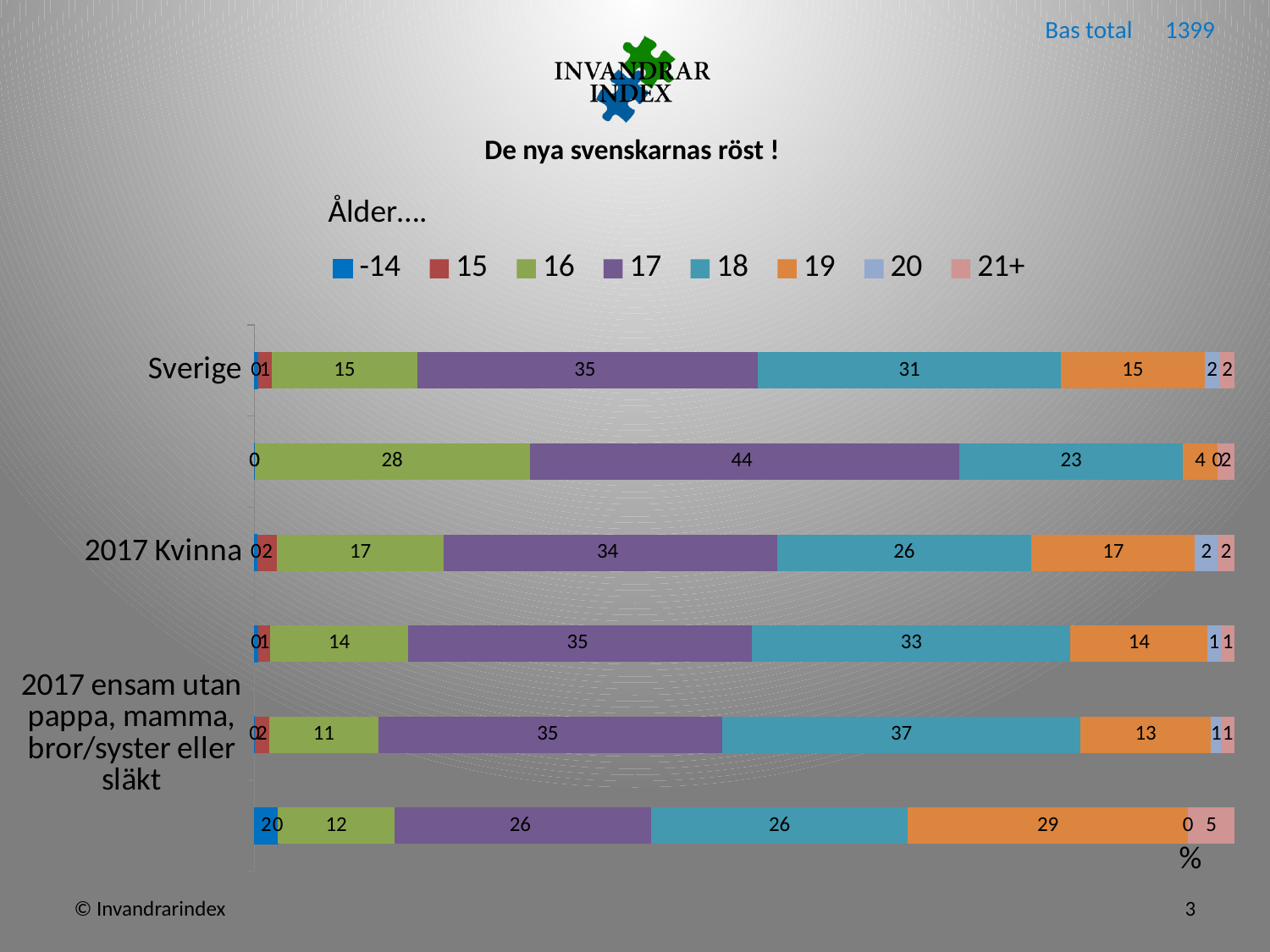
Which age series has the largest segment in the bar for 2017 ensam utan pappa, mamma, bror/syster eller släkt? 18 How many series does the legend of the chart list? 8 In the Sverige bar, what is the difference between the 17 series value and the 18 series value? 4 What is the value for the 17 series in the Sverige bar? 35 What is the value for the 18 series in the bar for 2017 ensam utan pappa, mamma, bror/syster eller släkt? 37 In the 2017 Kvinna bar, which is larger: the 17 series or the 18 series? 17 What is the value for the 18 series in the Sverige bar? 31 Which age series has the largest segment in the Sverige bar? 17 What is the value for the 16 series in the 2017 Kvinna bar? 17 What is the value for the 19 series in the 2017 Kvinna bar? 17 What kind of chart is shown on the slide? Stacked bar chart What is the title of the chart? Ålder….